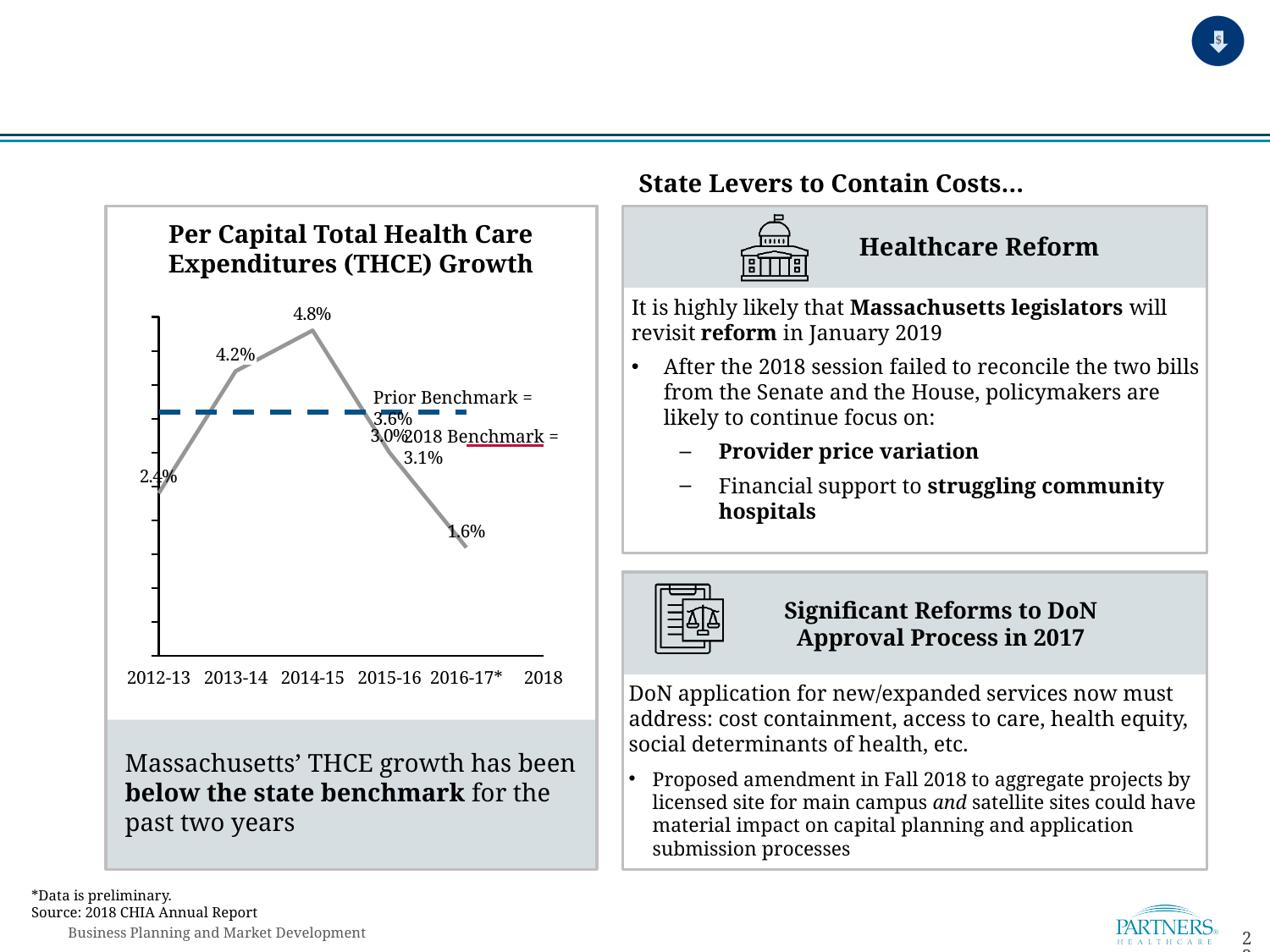
Which period has the lowest THCE growth value? 2016-17* What is the THCE growth value for 2014-15? 4.8% Which is larger, the THCE growth value for 2013-14 or for 2015-16? 2013-14 What is the THCE growth value for 2016-17*? 1.6% What is the THCE growth value for 2012-13? 2.4% Which period has the highest THCE growth value? 2014-15 What value is given for the 2018 Benchmark on the chart? 3.1% What value is given for the Prior Benchmark shown as a dashed line on the chart? 3.6% Does the THCE growth line rise or fall from 2014-15 to 2016-17*? Fall What is the difference between the THCE growth values for 2014-15 and 2012-13? 2.4 percentage points How many data points are plotted on the THCE growth line? 5 What type of chart is shown under the title "Per Capital Total Health Care Expenditures (THCE) Growth"? Line chart